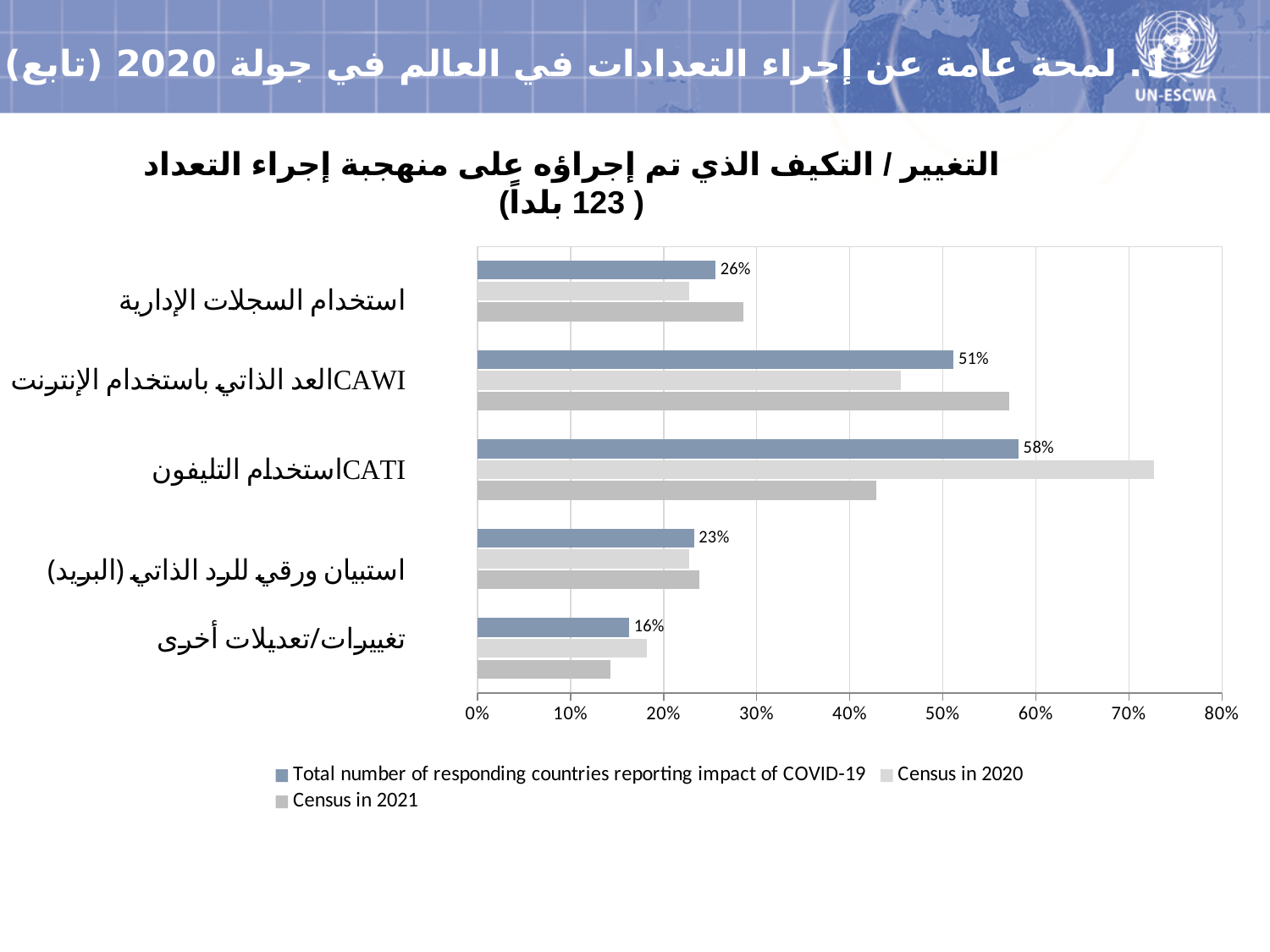
Is the 'Census in 2021' value for تغييرات/تعديلات أخرى greater or less than 20%? less What is the value of the 'Total number of responding countries reporting impact of COVID-19' series for CAWI العد الذاتي باستخدام الإنترنت? 51% Which category has the highest value in the 'Total number of responding countries reporting impact of COVID-19' series? CATI استخدام التليفون How many series does the legend list? 3 Which category has the lowest value in the 'Total number of responding countries reporting impact of COVID-19' series? تغييرات/تعديلات أخرى For CATI استخدام التليفون, which is larger: the 'Census in 2020' value or the 'Census in 2021' value? Census in 2020 In the 'Total number of responding countries reporting impact of COVID-19' series, what is the difference between the values for CATI استخدام التليفون and تغييرات/تعديلات أخرى? 42 percentage points Is the 'Census in 2020' value for CATI استخدام التليفون greater or less than 70%? greater How many categories are shown on the chart? 5 What is the value of the 'Total number of responding countries reporting impact of COVID-19' series for استخدام السجلات الإدارية? 26% What is the value of the 'Total number of responding countries reporting impact of COVID-19' series for CATI استخدام التليفون? 58% What type of chart is shown on the slide? bar chart